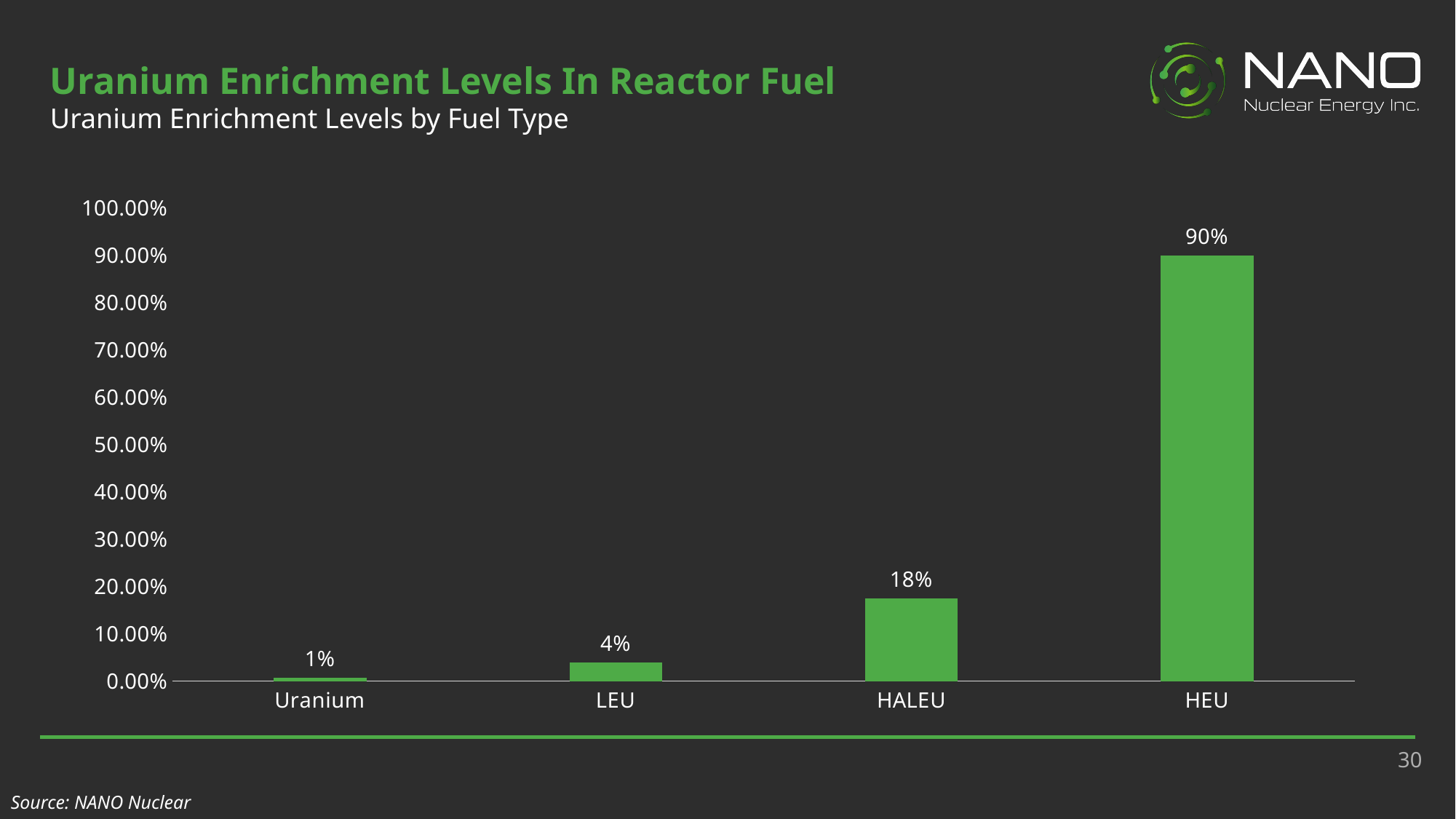
Which has a higher enrichment level, LEU or HALEU? HALEU What is the difference in enrichment level between HEU and HALEU? 72% Is the value for HEU greater or less than 80.00%? greater What is the uranium enrichment level shown for LEU? 4% How many fuel types are shown on the chart? 4 What is the uranium enrichment level shown for HEU? 90% What kind of chart is shown on the slide? Bar chart What is the difference in enrichment level between HALEU and LEU? 14% What is the uranium enrichment level shown for Uranium? 1% What is the uranium enrichment level shown for HALEU? 18% Which fuel type has the lowest enrichment level? Uranium Which fuel type has the highest enrichment level? HEU